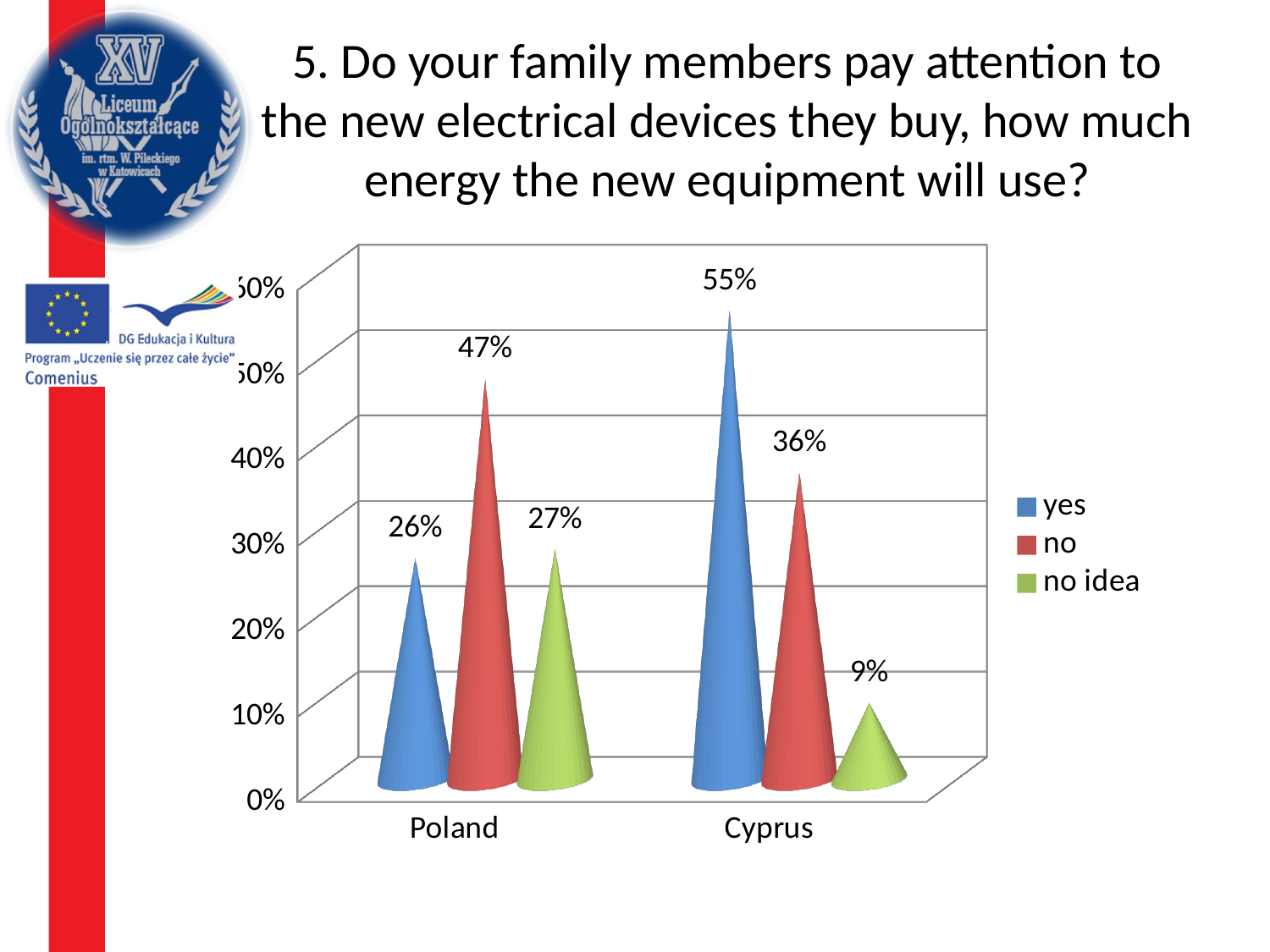
What kind of chart is shown on the slide? bar chart What percentage of respondents in Poland answered "no"? 47% What percentage of respondents in Cyprus answered "no idea"? 9% What percentage of respondents in Cyprus answered "yes"? 55% What colour represents the "no idea" series? green What is the difference between the "yes" values for Cyprus and Poland? 29% Which answer has the highest value for Cyprus? yes What percentage of respondents in Poland answered "yes"? 26% How many series does the legend list? 3 Which country has the larger "no" value, Poland or Cyprus? Poland How many countries are shown on the x axis? 2 Which answer has the lowest value for Poland? yes